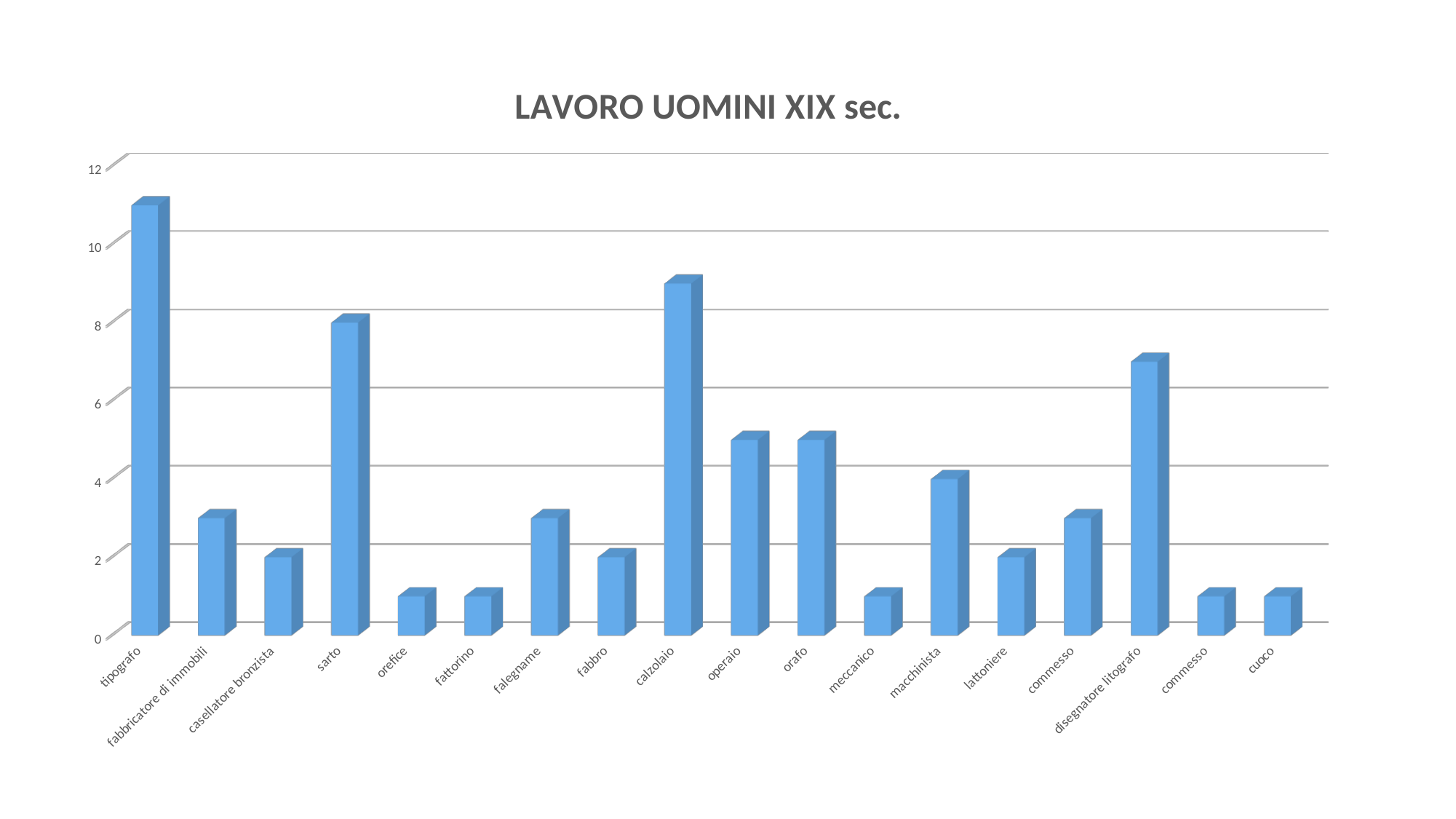
Which is larger, the value for tipografo or the value for calzolaio? tipografo Is the value for orefice greater or less than 2? less Is the value for calzolaio greater or less than 8? greater Which category has the highest value? tipografo What is the title of the chart? LAVORO UOMINI XIX sec. Is the value for disegnatore litografo greater or less than 6? greater What is the value for sarto? 8 How many categories are shown on the x axis? 18 What kind of chart is shown on the slide? bar chart What is the value for macchinista? 4 Which is larger, the value for operaio or the value for meccanico? operaio